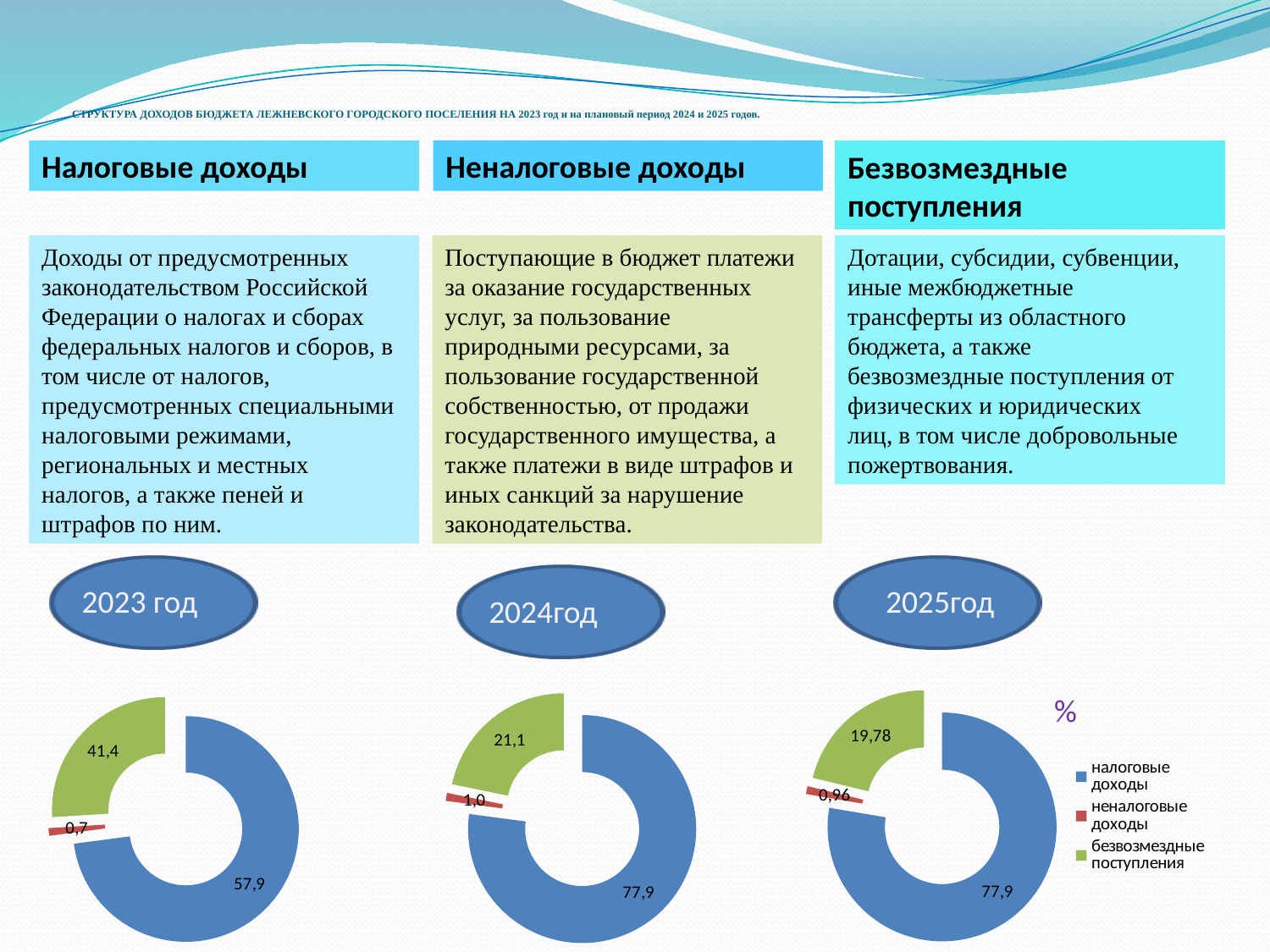
На диаграмме «2024год» на сколько доля налоговых доходов больше доли безвозмездных поступлений? 56,8 На диаграмме «2023 год» какова доля налоговых доходов? 57,9 Что больше: доля безвозмездных поступлений на диаграмме «2023 год» или на диаграмме «2025год»? 2023 год Сколько категорий показано на диаграмме «2024год»? 3 На диаграмме «2024год» какова доля неналоговых доходов? 1,0 На диаграмме «2025год» какая категория имеет наименьшую долю? неналоговые доходы На диаграмме «2025год» какова доля безвозмездных поступлений? 19,78 Какого типа диаграмма «2025год»? кольцевая диаграмма На диаграмме «2024год» какая категория имеет наибольшую долю? налоговые доходы Сколько элементов перечислено в легенде справа от диаграммы «2025год»? 3 На диаграмме «2023 год» на сколько доля налоговых доходов больше доли безвозмездных поступлений? 16,5 На диаграмме «2023 год» какова доля безвозмездных поступлений? 41,4